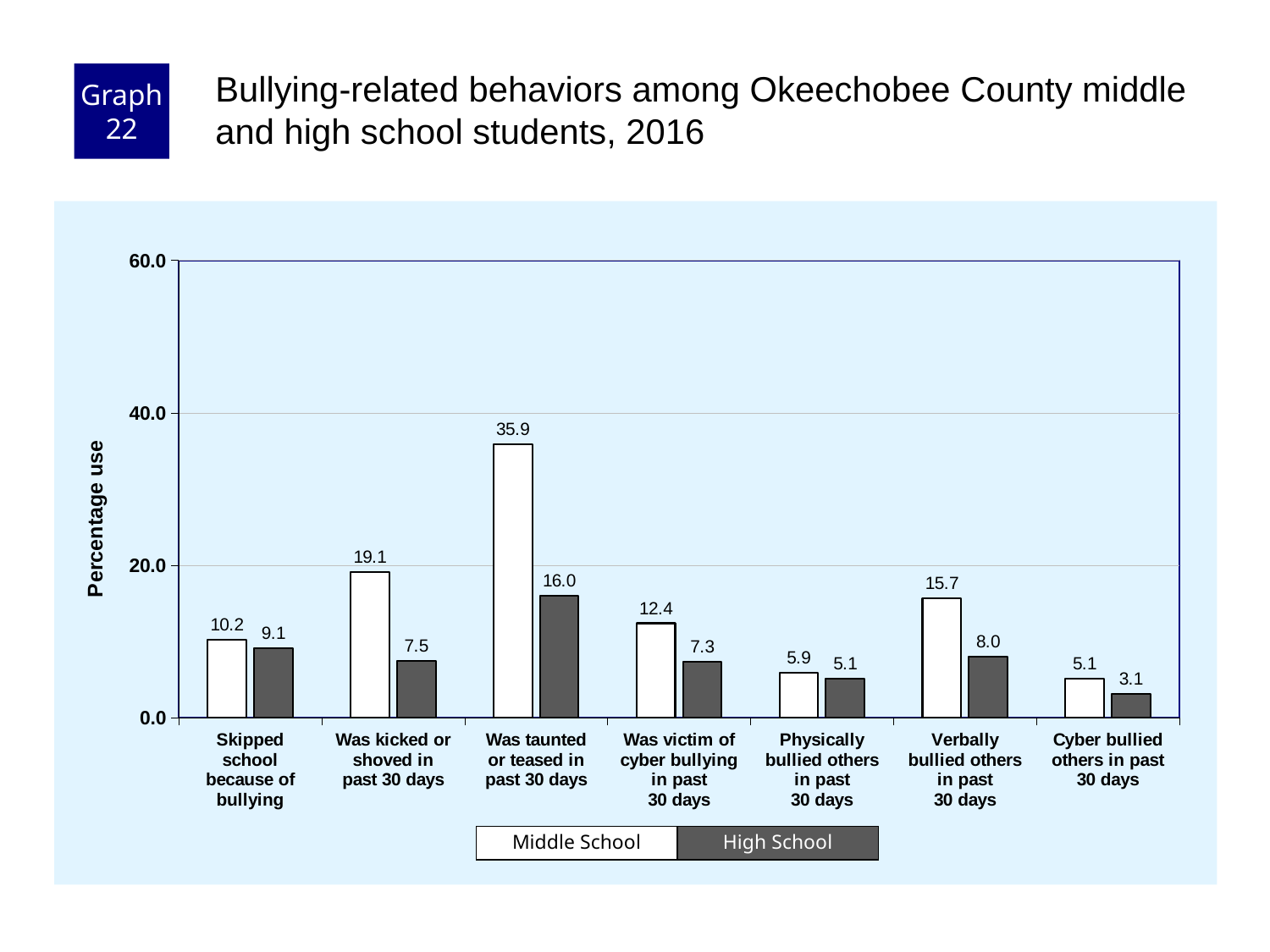
Which is larger for 'Verbally bullied others in past 30 days': the middle school value or the high school value? Middle School What is the difference between the middle school and high school values for 'Was kicked or shoved in past 30 days'? 11.6 How many series does the legend list? 2 What percentage of high school students skipped school because of bullying? 9.1 How many behavior categories are shown on the x axis? 7 Which behavior has the highest value for middle school students? Was taunted or teased in past 30 days Is the middle school value for 'Was taunted or teased in past 30 days' greater or less than 20.0? greater Which behavior has the lowest value for high school students? Cyber bullied others in past 30 days What percentage of middle school students were taunted or teased in the past 30 days? 35.9 What type of chart is shown on the slide? bar chart What percentage of high school students were victims of cyber bullying in the past 30 days? 7.3 What is the label of the y axis? Percentage use